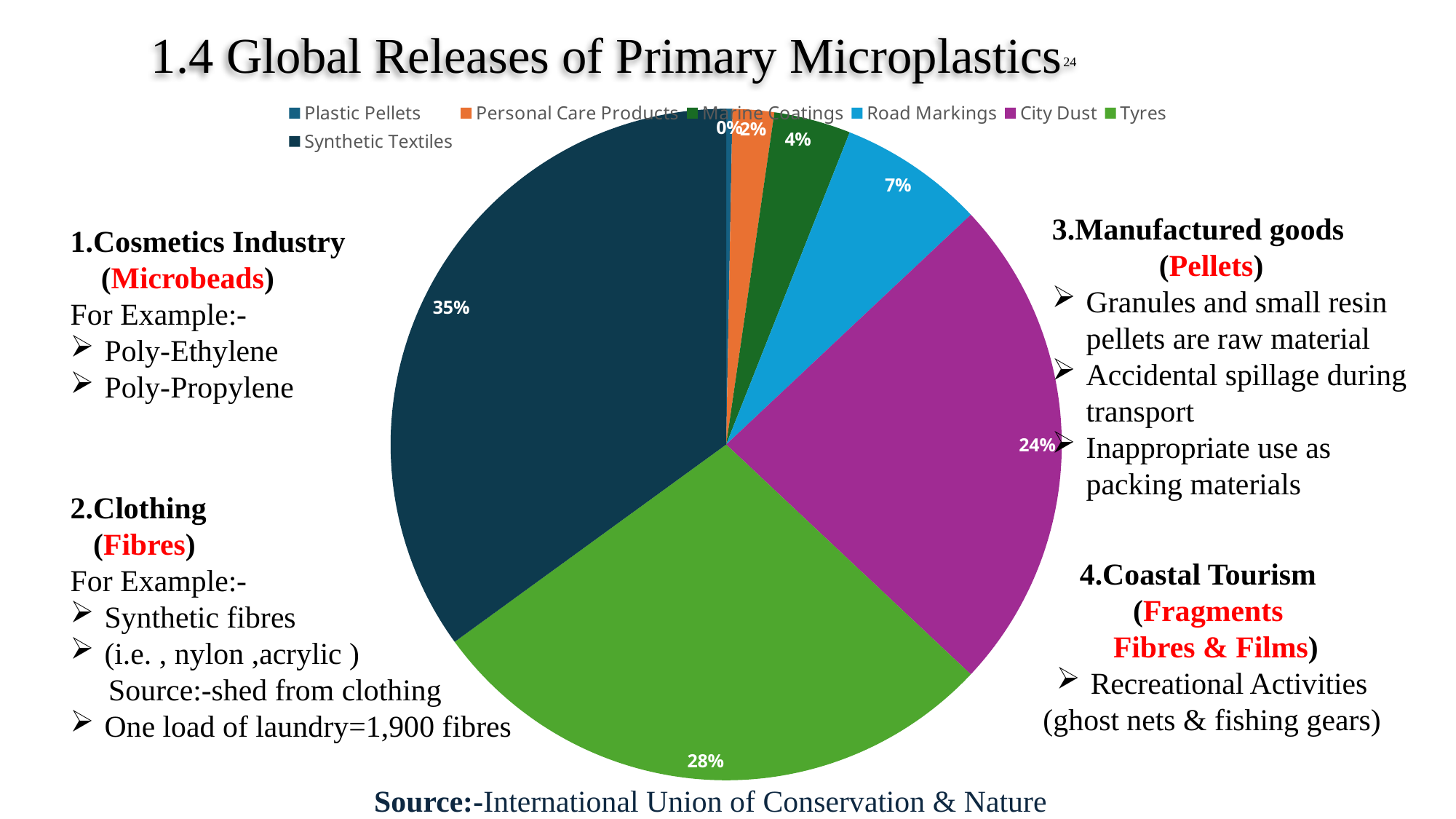
What share of the pie does Tyres have? 28% What share of the pie does Road Markings have? 7% Which category has the smallest slice of the pie? Plastic Pellets What share of the pie does Personal Care Products have? 2% What is the difference between the shares of Synthetic Textiles and Tyres? 7% Which has a larger share, City Dust or Road Markings? City Dust What kind of chart is shown on the slide? pie chart Which category has the largest slice of the pie? Synthetic Textiles How many categories does the legend list? 7 What colour is the Tyres slice of the pie? green